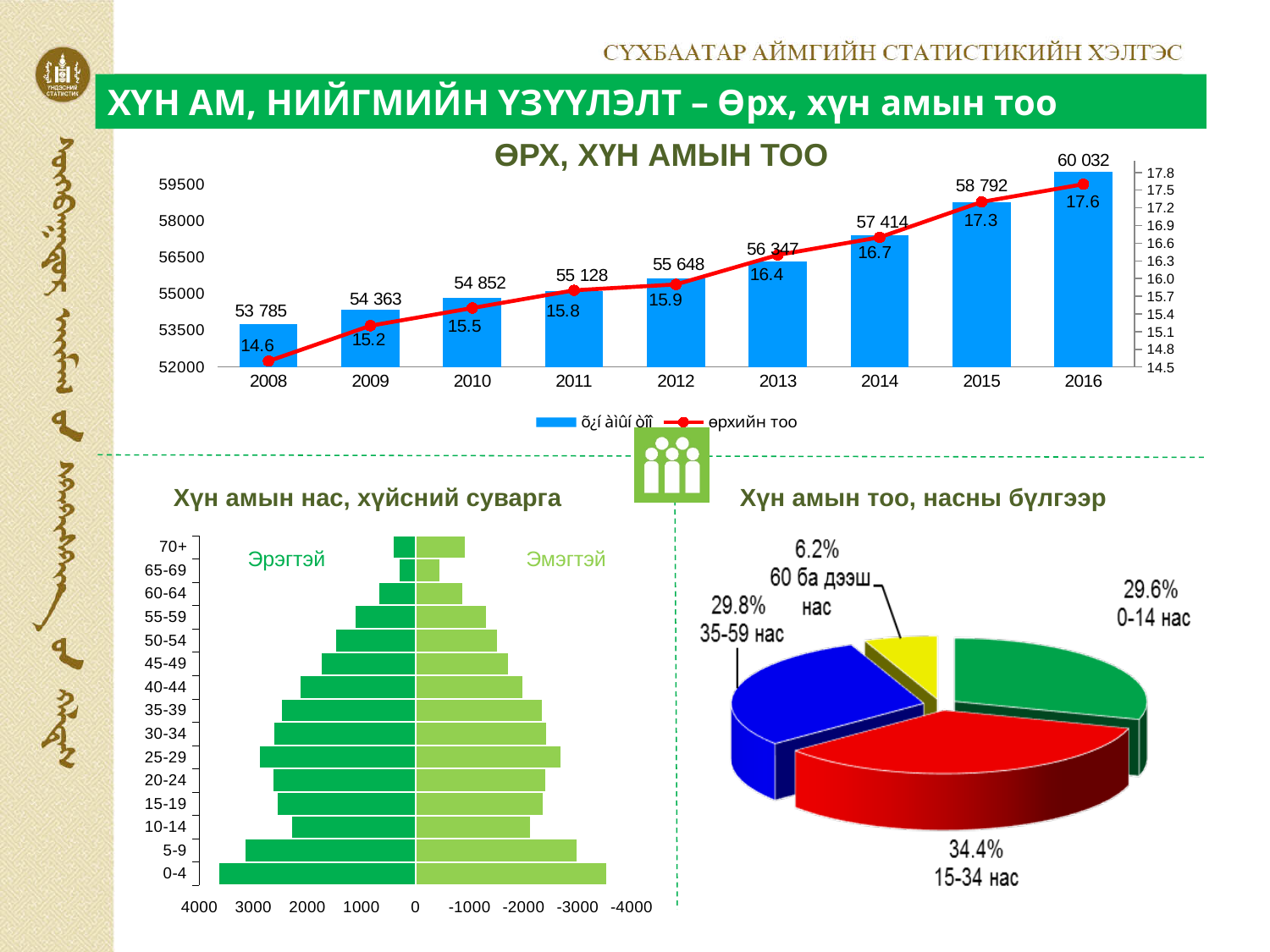
In the chart titled 'ӨРХ, ХҮН АМЫН ТОО', do the bar values rise or fall from 2008 to 2016? rise In the chart titled 'ӨРХ, ХҮН АМЫН ТОО', what is the difference between the bar values for 2016 and 2015? 1 240 In the chart titled 'ӨРХ, ХҮН АМЫН ТОО', is the 'өрхийн тоо' value for 2014 greater or less than 16.7? equal to 16.7 In the chart titled 'ӨРХ, ХҮН АМЫН ТОО', what is the value of the 'өрхийн тоо' line for 2012? 15.9 In the chart titled 'Хүн амын нас, хүйсний суварга', how many age groups are listed on the vertical axis? 15 In the pie chart titled 'Хүн амын тоо, насны бүлгээр', how many slices are there? 4 In the chart titled 'ӨРХ, ХҮН АМЫН ТОО', what is the bar value for 2016? 60 032 In the pie chart titled 'Хүн амын тоо, насны бүлгээр', which is larger: the '0-14 нас' slice or the '35-59 нас' slice? 35-59 нас In the pie chart titled 'Хүн амын тоо, насны бүлгээр', what share does the '15-34 нас' slice have? 34.4% In the chart titled 'ӨРХ, ХҮН АМЫН ТОО', which year has the lowest bar value? 2008 In the pie chart titled 'Хүн амын тоо, насны бүлгээр', which age group has the smallest slice? 60 ба дээш нас In the chart titled 'ӨРХ, ХҮН АМЫН ТОО', how many years are shown on the x axis? 9